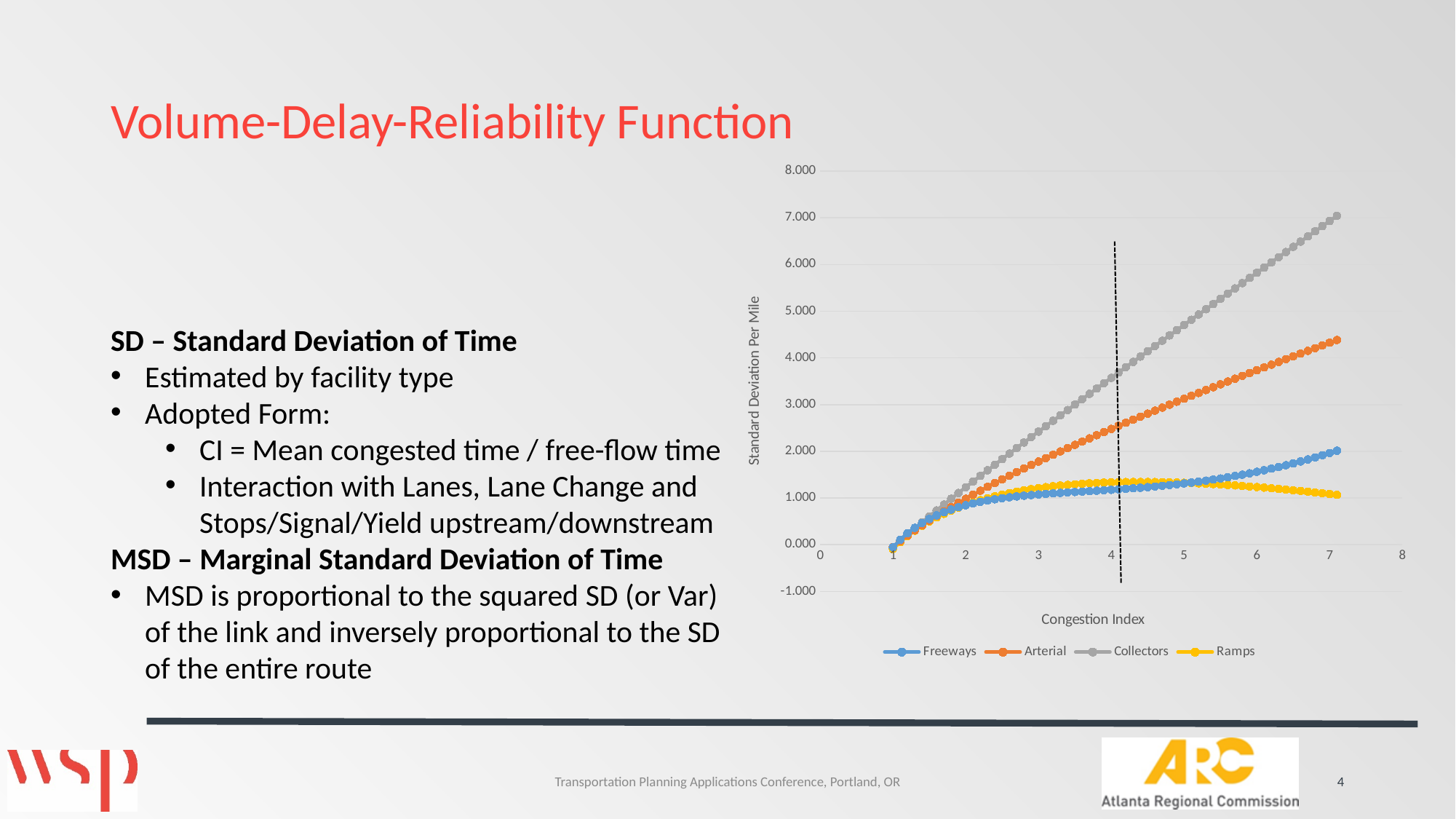
Is the value for Collectors at a Congestion Index of 4 greater or less than 3.000? greater Does the Collectors series rise or fall as the Congestion Index increases? rise Is the value for Arterial at a Congestion Index of 7 greater or less than 4.000? greater Does the Ramps series rise or fall between a Congestion Index of 5 and 7? fall At a Congestion Index of 7, which is larger: Freeways or Ramps? Freeways What is the label of the chart's vertical axis? Standard Deviation Per Mile Which series has the lowest Standard Deviation Per Mile at a Congestion Index of 7? Ramps Which series has the highest Standard Deviation Per Mile at a Congestion Index of 7? Collectors How many series does the chart legend list? 4 Is the value for Collectors at a Congestion Index of 7 greater or less than 6.000? greater What kind of chart is shown on the slide? line chart